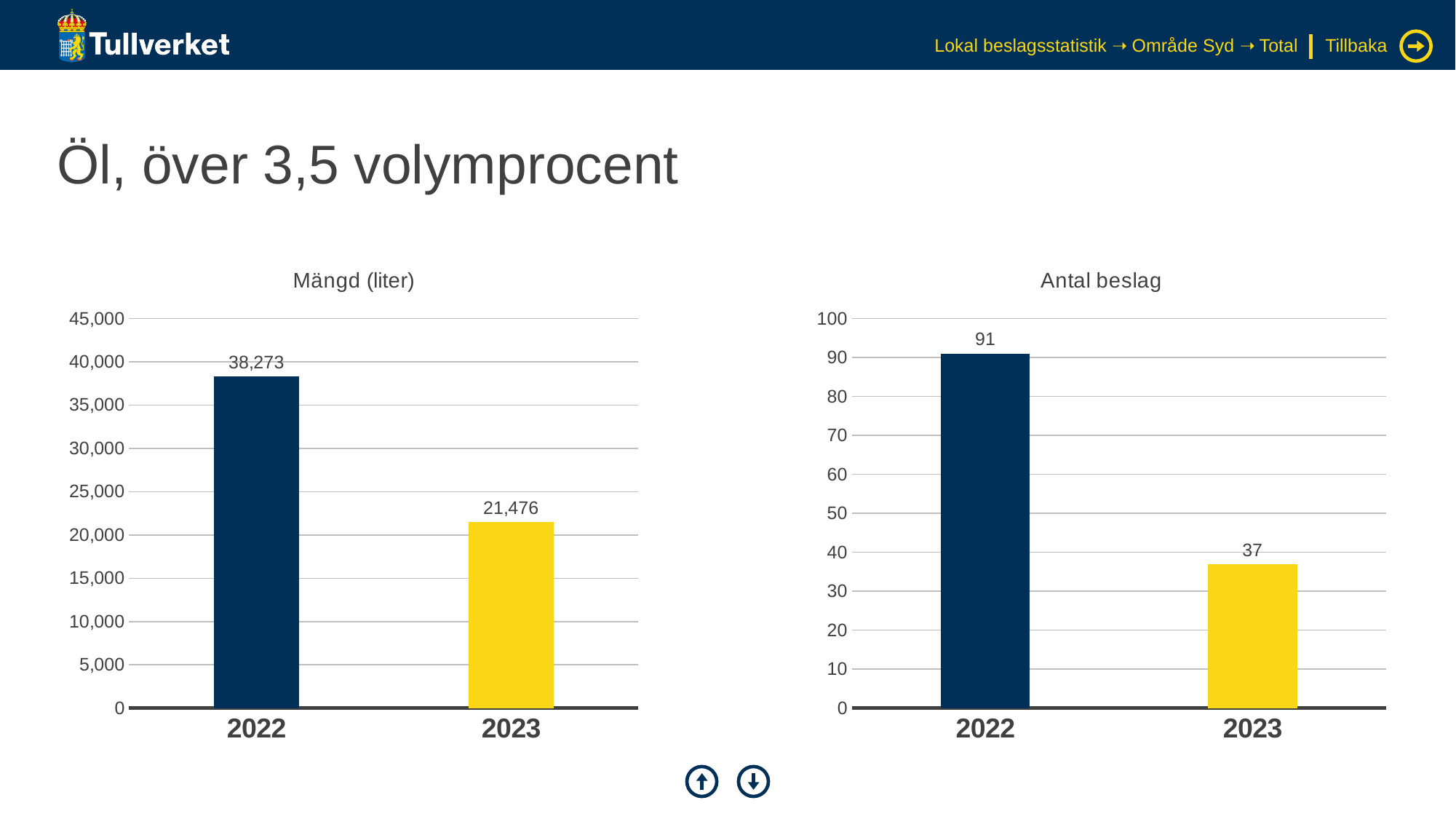
In the 'Antal beslag' chart, which year has the lowest value? 2023 What kind of chart is the 'Antal beslag' chart? bar chart In the 'Mängd (liter)' chart, what is the value for 2023? 21,476 In the 'Antal beslag' chart, is the value for 2023 greater or less than 40? less How many categories are shown on the x axis of the 'Mängd (liter)' chart? 2 In the 'Antal beslag' chart, what is the value for 2022? 91 In the 'Antal beslag' chart, what is the value for 2023? 37 In the 'Mängd (liter)' chart, what is the value for 2022? 38,273 In the 'Mängd (liter)' chart, what is the difference between the 2022 and 2023 values? 16,797 In the 'Antal beslag' chart, what is the difference between the 2022 and 2023 values? 54 In the 'Mängd (liter)' chart, do the values rise or fall from 2022 to 2023? fall In the 'Mängd (liter)' chart, which year has the highest value? 2022